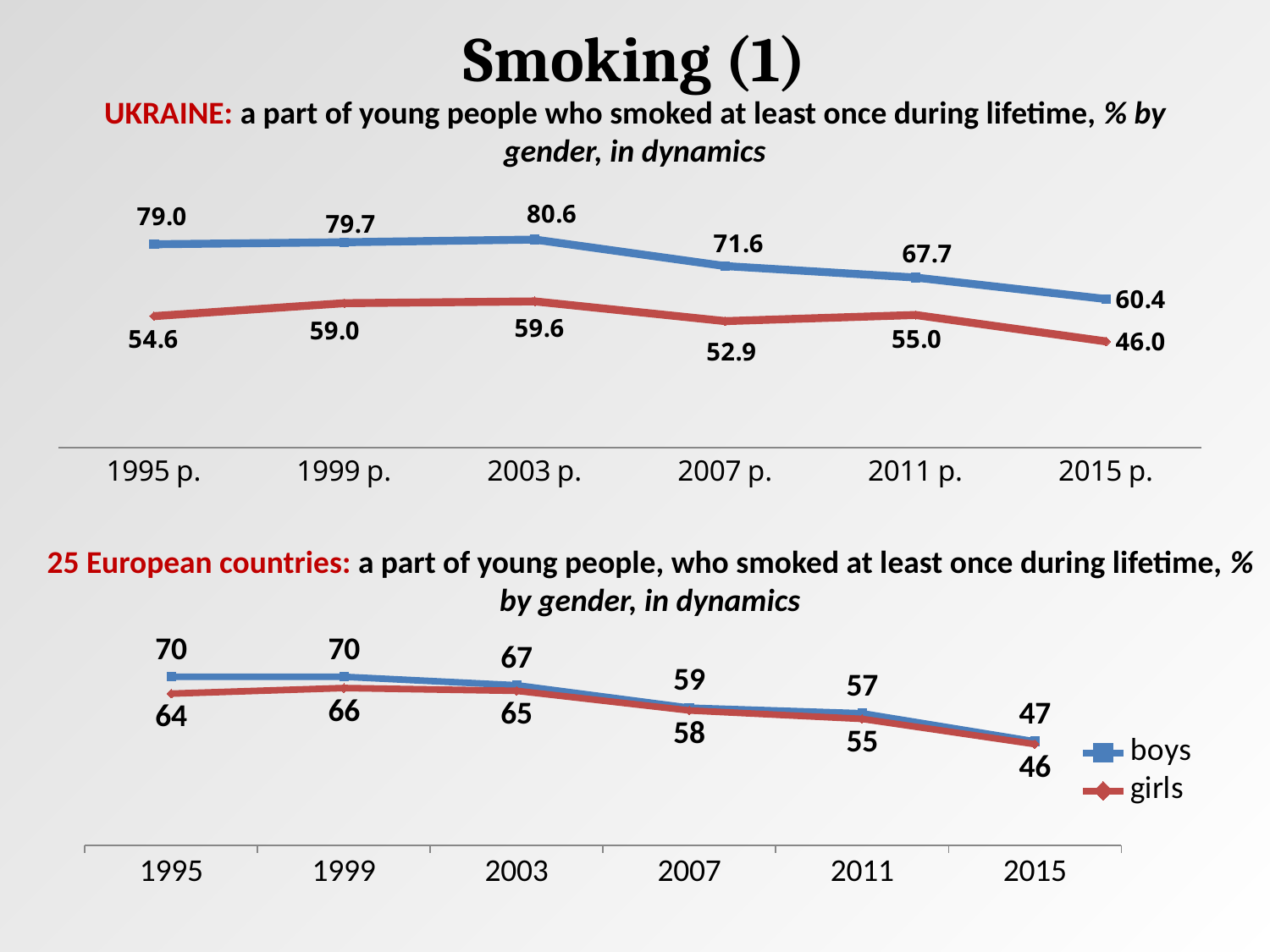
What kind of chart is the 25 European countries chart? line chart In the 25 European countries chart, what is the value for boys in 2011? 57 In the 25 European countries chart, do the boys' values rise or fall from 2003 to 2015? fall In the UKRAINE chart, how many years are shown on the x axis? 6 In the UKRAINE chart, in which year is the boys' value highest? 2003 In the UKRAINE chart, what is the value for boys in 2003? 80.6 In the UKRAINE chart, what is the difference between boys and girls in 2015? 14.4 In the 25 European countries chart, what is the difference between boys and girls in 1995? 6 In the UKRAINE chart, what is the value for girls in 2007? 52.9 In the 25 European countries chart, how many series does the legend list? 2 In the 25 European countries chart, what is the value for girls in 1999? 66 In the UKRAINE chart, in which year is the girls' value lowest? 2015